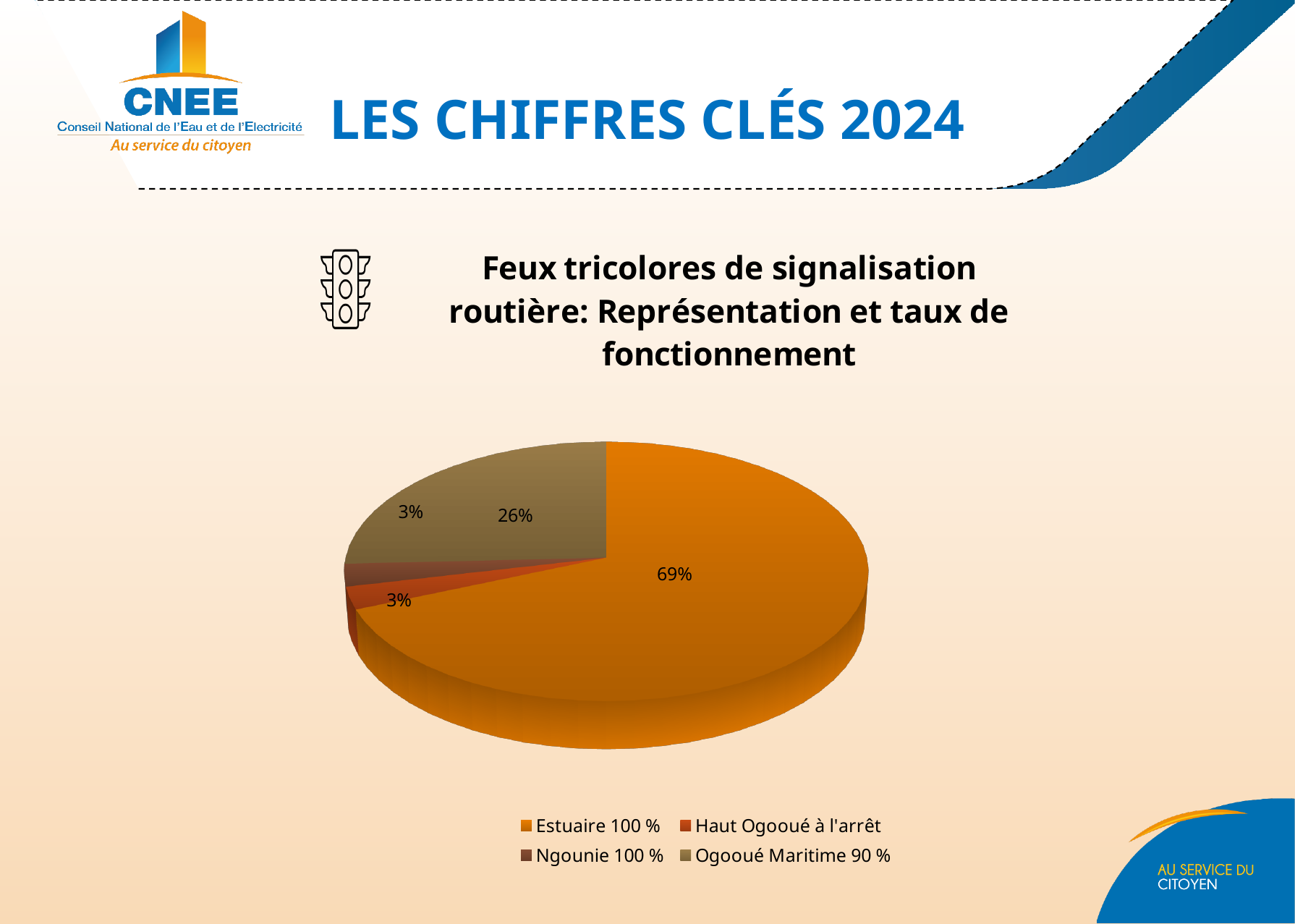
What percentage is shown for Ngounie 100 %? 3% Which slice is larger: Ogooué Maritime 90 % or Haut Ogooué à l'arrêt? Ogooué Maritime 90 % What type of chart is shown on the slide? Pie chart What percentage is shown for Haut Ogooué à l'arrêt? 3% Which category has the largest slice of the pie? Estuaire 100 % What is the title of the chart? Feux tricolores de signalisation routière: Représentation et taux de fonctionnement What percentage is shown for Ogooué Maritime 90 %? 26% How many slices does the pie chart have? 4 What share of the pie does Estuaire 100 % represent? 69% How many entries does the legend list? 4 What colour is the Estuaire 100 % slice? Orange What is the difference in percentage points between the Estuaire 100 % slice and the Ogooué Maritime 90 % slice? 43 percentage points